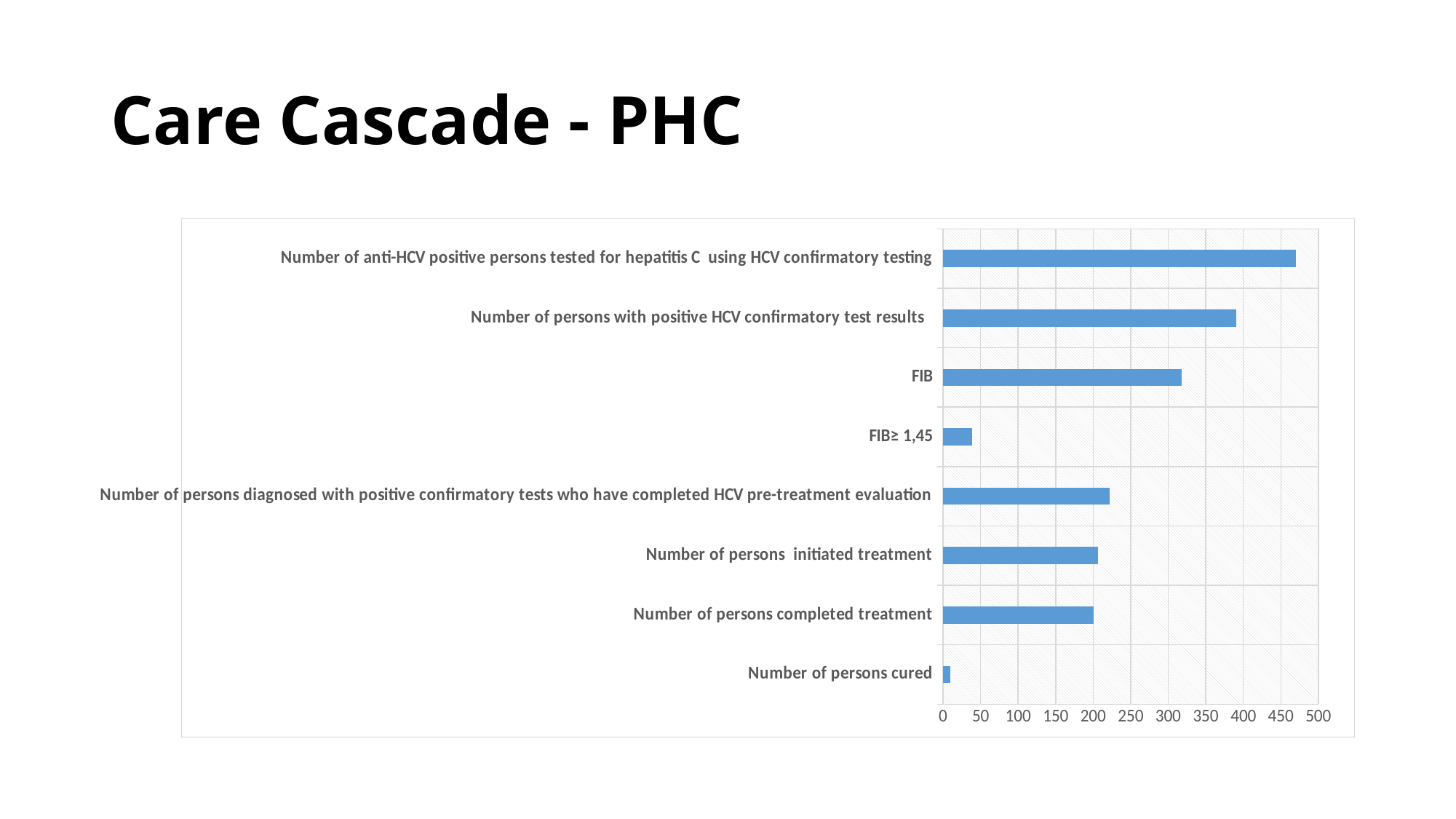
Which category has the highest value? Number of anti-HCV positive persons tested for hepatitis C using HCV confirmatory testing Which is larger, the value for Number of persons with positive HCV confirmatory test results or the value for Number of persons initiated treatment? Number of persons with positive HCV confirmatory test results Is the value for Number of anti-HCV positive persons tested for hepatitis C using HCV confirmatory testing greater or less than 450? greater How many categories are plotted in the chart? 8 Which is larger, the value for FIB or the value for FIB≥ 1,45? FIB Is the value for Number of persons cured greater or less than 50? less What is the title of the slide containing the chart? Care Cascade - PHC Is the value for FIB≥ 1,45 greater or less than 50? less Which category has the lowest value? Number of persons cured What kind of chart is shown on the slide? bar chart